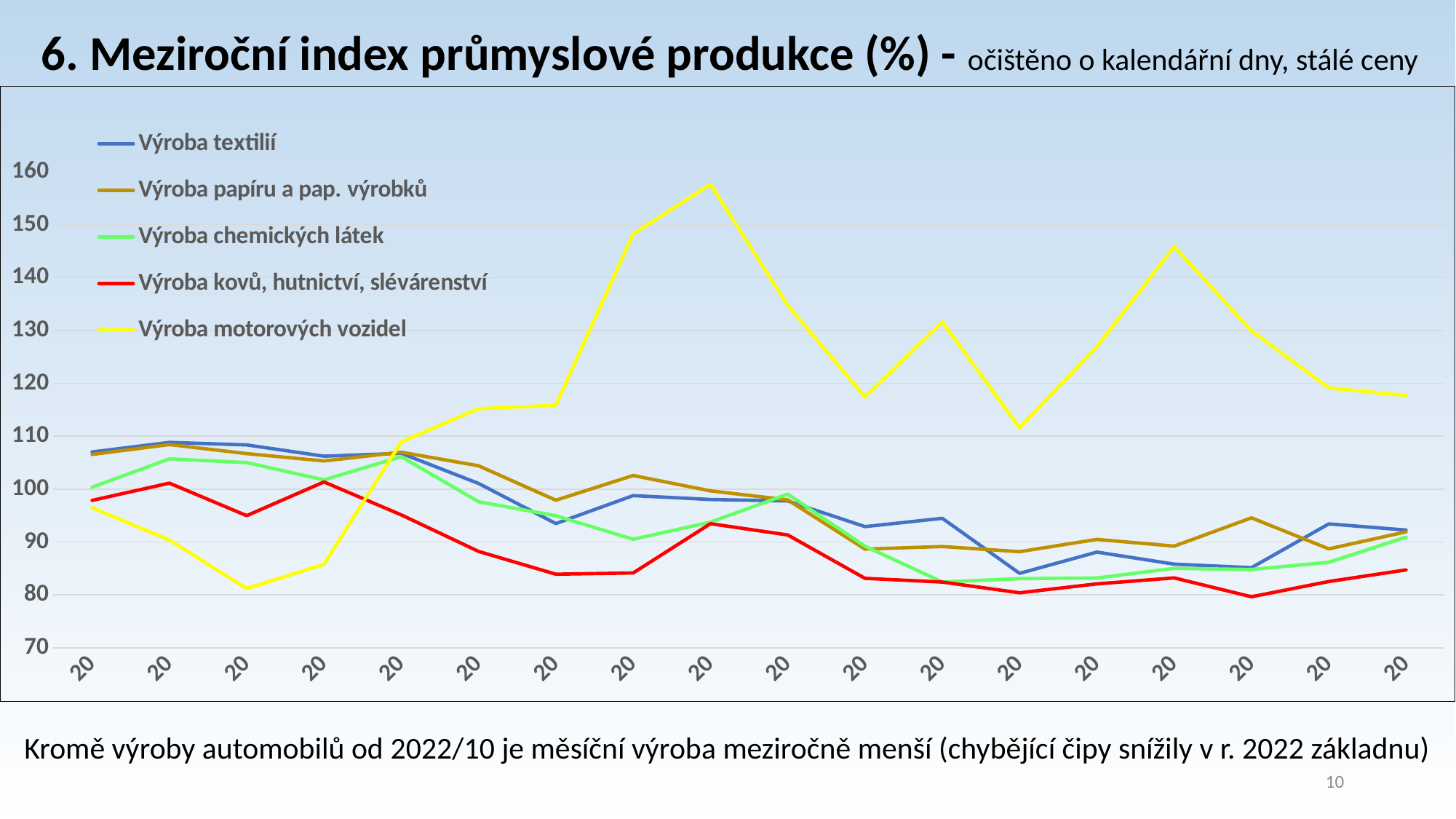
How many series does the legend list? 5 Overall, does the Výroba kovů, hutnictví, slévárenství line rise or fall from the left of the x axis to the right? fall Is the value of Výroba motorových vozidel at the last point on the x axis greater or less than 110? greater Is the peak value of the Výroba motorových vozidel line greater or less than 150? greater What is the lowest value shown on the vertical axis? 70 What colour is the line for Výroba motorových vozidel? yellow Is the value of Výroba kovů, hutnictví, slévárenství at the last point on the x axis greater or less than 90? less Which series reaches the highest value anywhere on the chart? Výroba motorových vozidel What kind of chart is shown on the slide? line chart At the first point on the x axis, which is larger: Výroba textilií or Výroba kovů, hutnictví, slévárenství? Výroba textilií At the last point on the x axis, which is larger: Výroba motorových vozidel or Výroba kovů, hutnictví, slévárenství? Výroba motorových vozidel